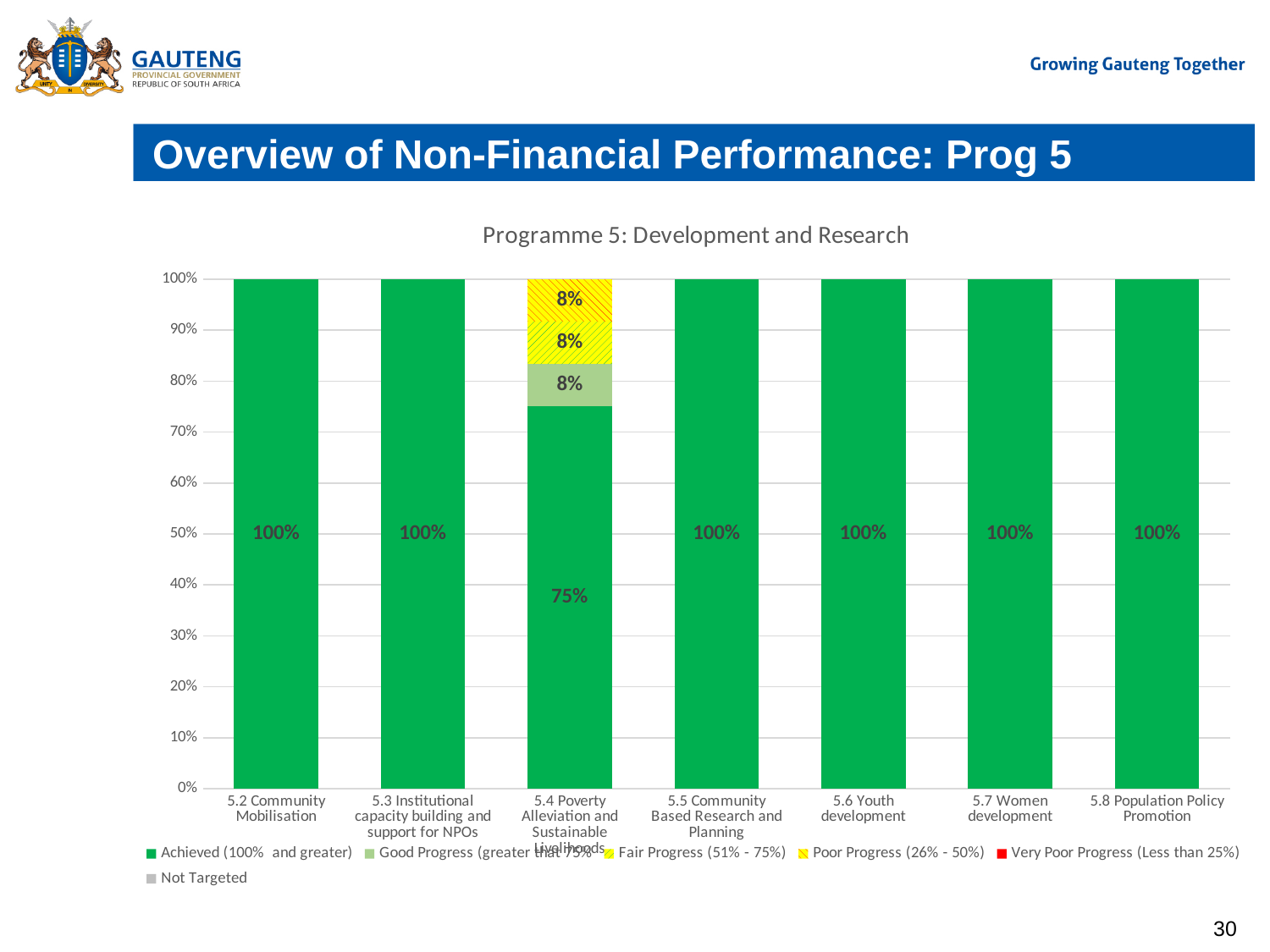
Which has the larger Achieved value, 5.3 Institutional capacity building and support for NPOs or 5.4 Poverty Alleviation and Sustainable Livelihoods? 5.3 Institutional capacity building and support for NPOs What is the Achieved value for 5.4 Poverty Alleviation and Sustainable Livelihoods? 75% What is the Achieved value for 5.6 Youth development? 100% What is the Poor Progress value for 5.4 Poverty Alleviation and Sustainable Livelihoods? 8% What is the difference between the Achieved value for 5.2 Community Mobilisation and the Achieved value for 5.4 Poverty Alleviation and Sustainable Livelihoods? 25% Is the Achieved value for 5.4 Poverty Alleviation and Sustainable Livelihoods greater or less than 80%? less How many categories are shown on the x axis of the chart? 7 Which category has the lowest Achieved value? 5.4 Poverty Alleviation and Sustainable Livelihoods How many series does the legend list? 6 What kind of chart is shown on the slide? Stacked bar chart What is the Good Progress value for 5.4 Poverty Alleviation and Sustainable Livelihoods? 8% What is the title of the chart? Programme 5: Development and Research